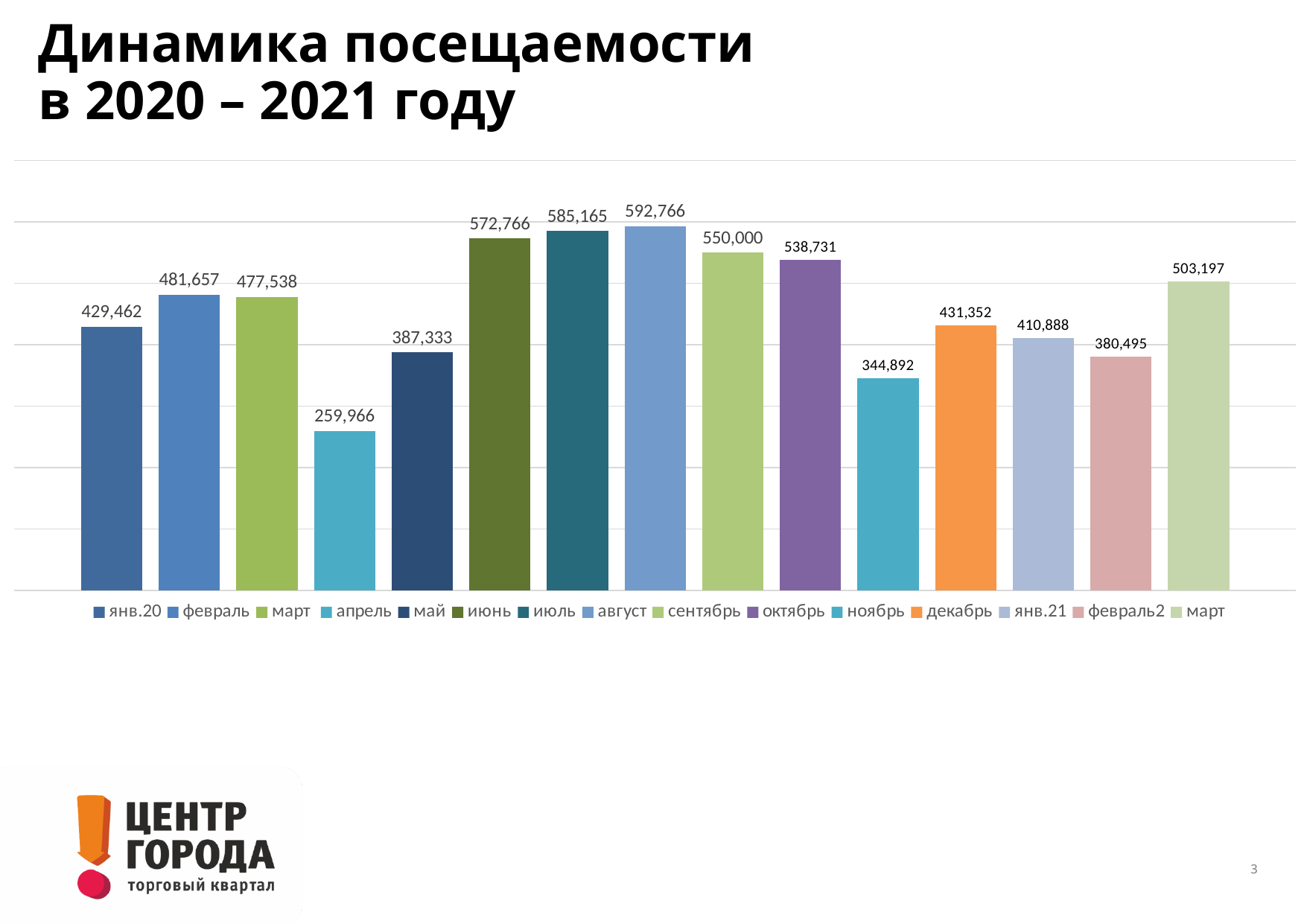
What is the value for апрель? 259,966 What kind of chart is shown on the slide? bar chart What is the value for янв.21? 410,888 What is the difference between the values for август and июль? 7,601 How many bars are plotted in the chart? 15 Do the values rise or fall from апрель to август? rise What is the difference between the values for февраль (2020) and янв.20? 52,195 What is the value for август? 592,766 Which month has the highest value? август What is the value for the last bar on the right (март 2021)? 503,197 Which is larger, the value for ноябрь or the value for декабрь? декабрь Which month has the lowest value? апрель